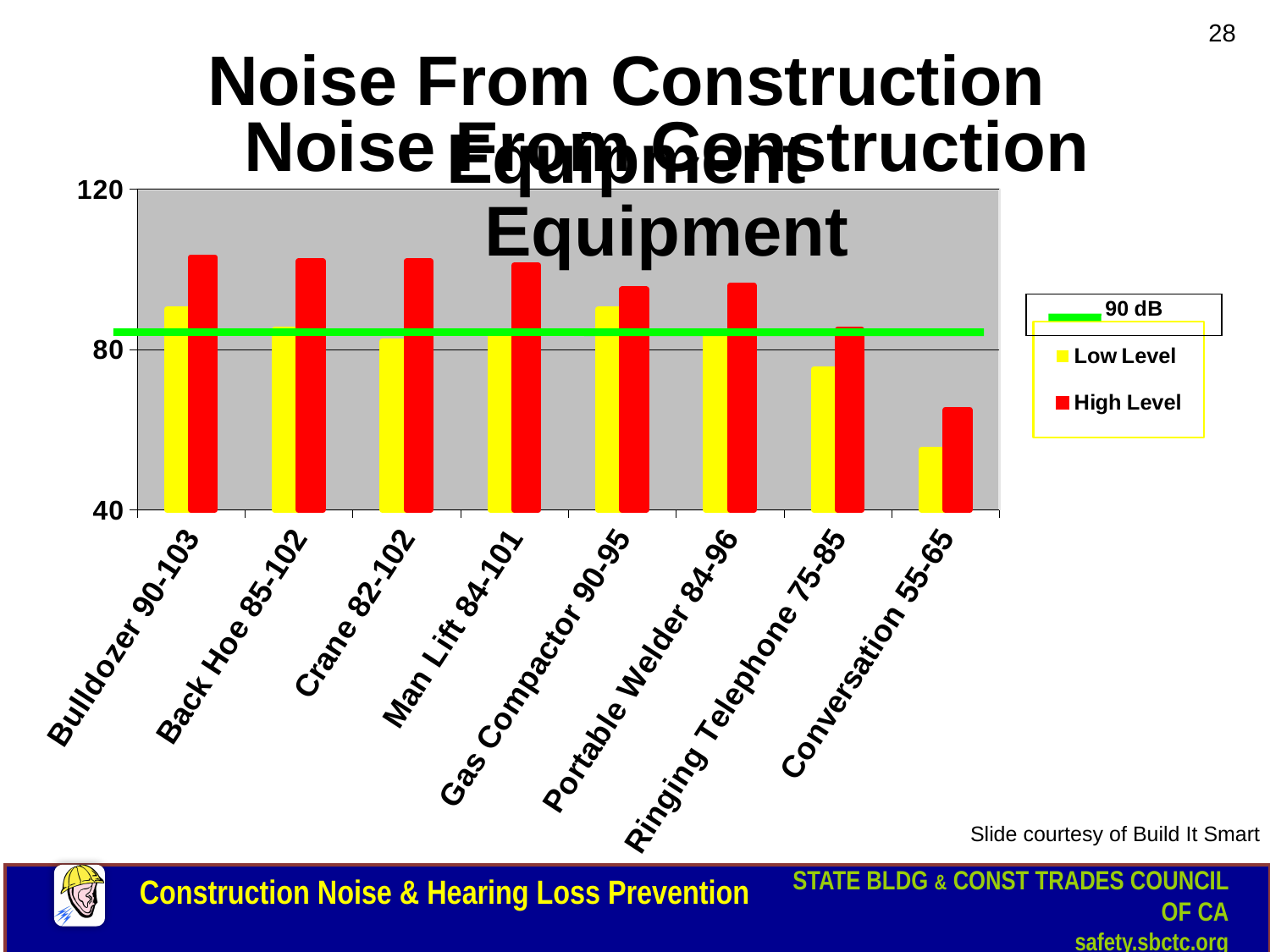
How many entries does the chart legend list? 3 Using the values in the category label, what is the difference between the high and low noise levels for the Bulldozer? 13 Which has a larger High Level value, Crane or Ringing Telephone? Crane Is the Low Level value for Ringing Telephone greater or less than 80? less How many equipment/noise categories are shown on the x axis? 8 According to the category label, what is the high noise level for the Bulldozer? 103 Do the High Level values generally rise or fall from left to right across the categories? fall According to the category label, what is the low noise level for Conversation? 55 Is the High Level value for Conversation greater or less than 80? less What kind of chart is shown on the slide? bar chart What level does the green horizontal line across the chart represent? 90 dB Which category has the lowest High Level value? Conversation